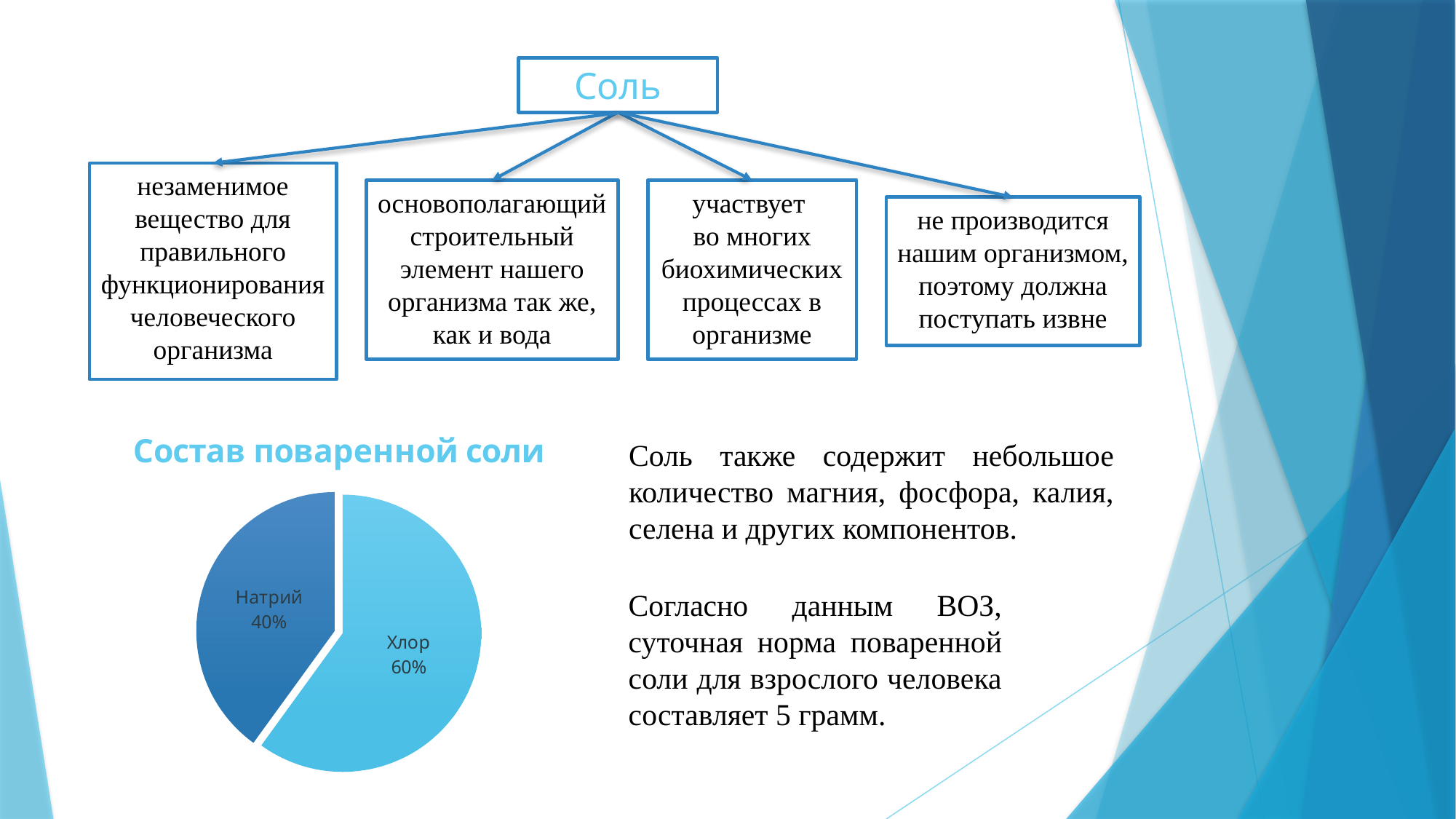
By how many percentage points does the Хлор slice exceed the Натрий slice? 20% Which slice of the pie chart is the largest? Хлор What kind of chart is shown under the title "Состав поваренной соли"? pie chart Which slice of the pie chart is the smallest? Натрий Which slice of the pie chart is drawn in the darker blue colour? Натрий How many slices does the pie chart have? 2 What share of the pie chart is labelled "Хлор"? 60% Is the share for Натрий greater or less than 50%? less What share of the pie chart is labelled "Натрий"? 40% What is the title of the pie chart on the slide? Состав поваренной соли Which is larger in the pie chart, Натрий or Хлор? Хлор